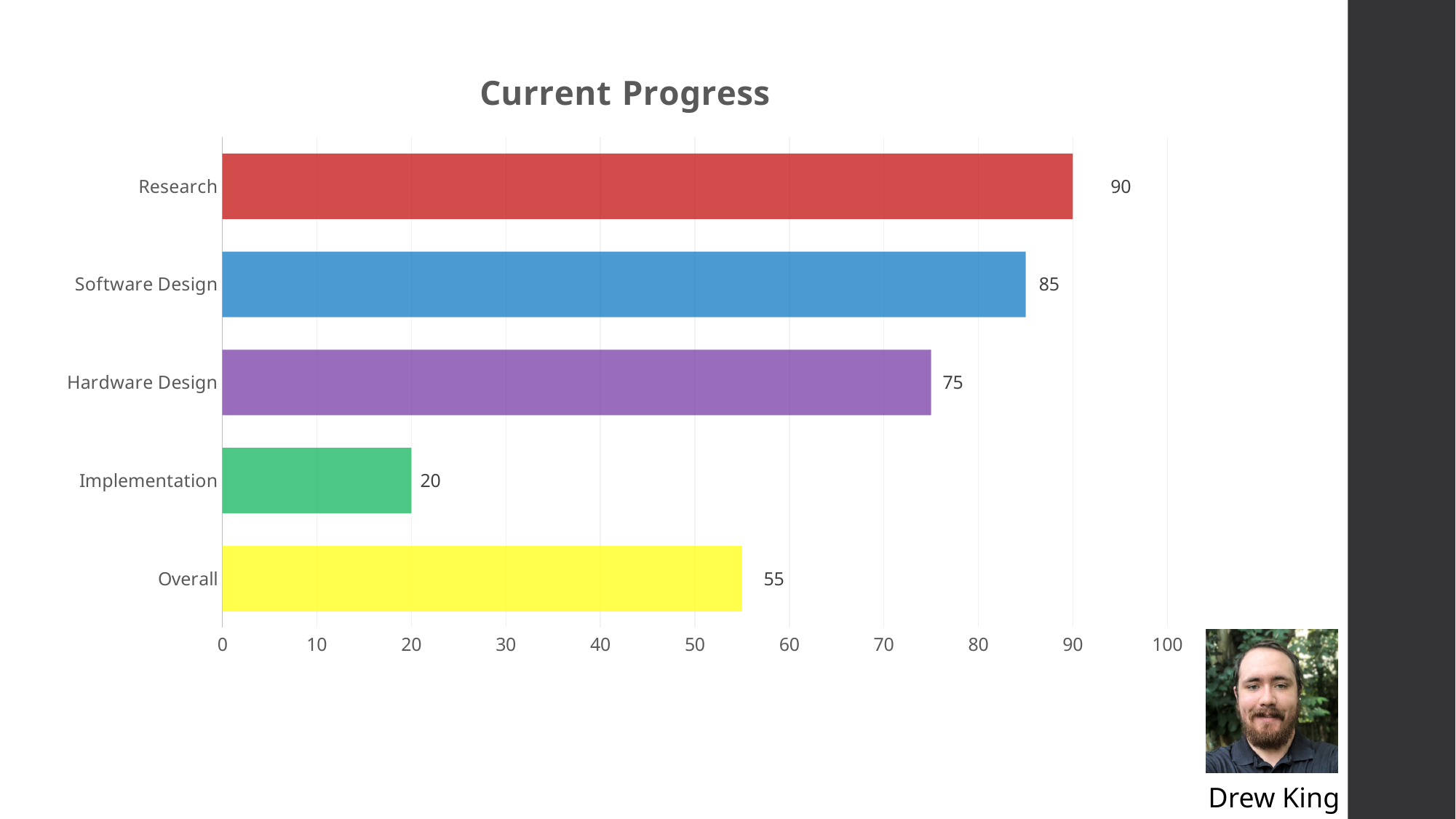
What is the value for Implementation? 20 What is the title of the chart? Current Progress Which category has the lowest value? Implementation What is the value for Software Design? 85 What is the difference between the values for Research and Implementation? 70 What is the value for Overall? 55 Which is larger, the value for Hardware Design or the value for Overall? Hardware Design What is the value for Research? 90 Which category has the highest value? Research What kind of chart is shown on the slide? Bar chart What is the difference between the values for Software Design and Hardware Design? 10 How many categories are shown in the chart? 5